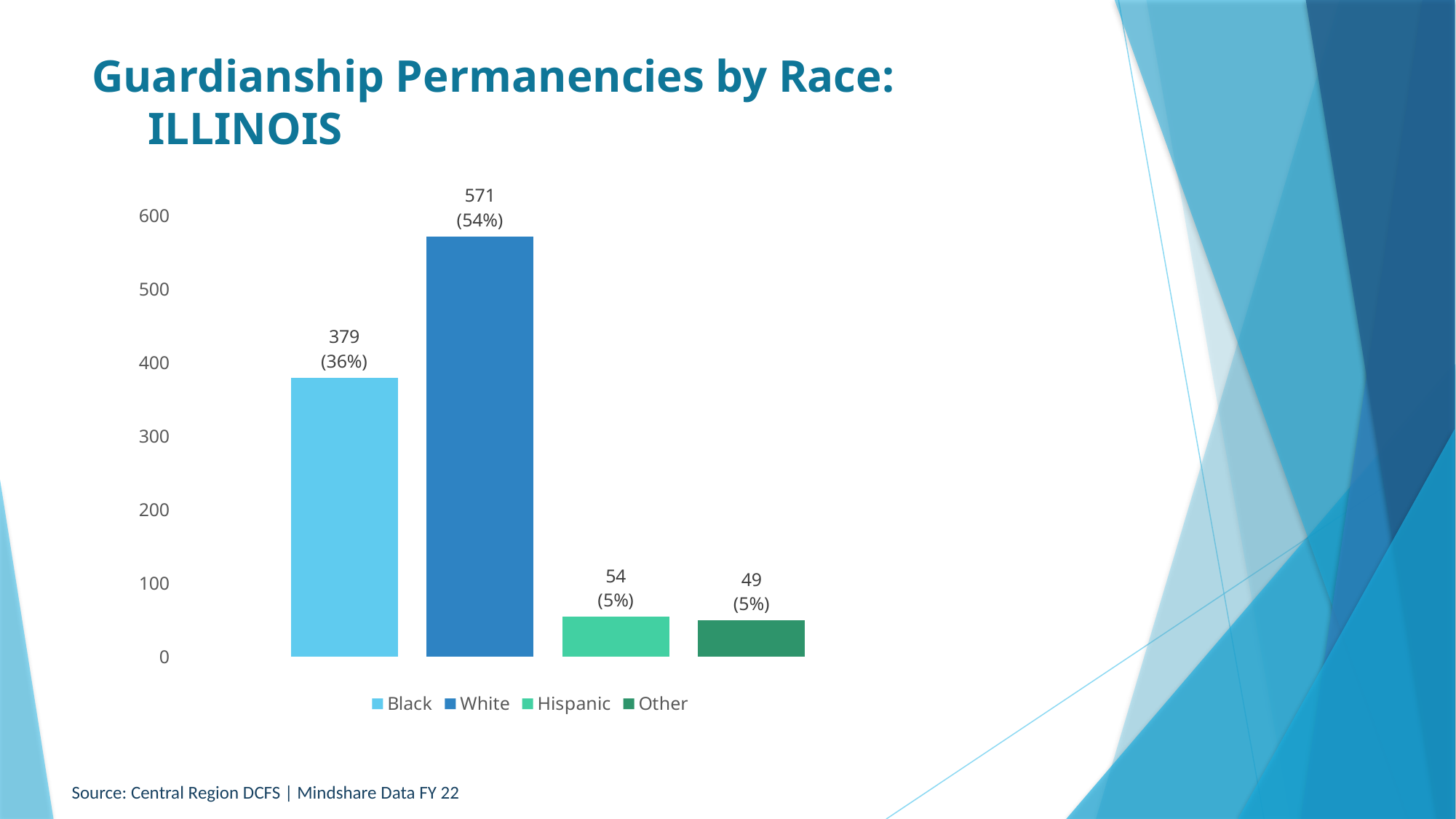
What is the value for Black? 379 What kind of chart is shown on the slide? bar chart Is the value for Black greater or less than 400? less What percentage is shown for Other? 5% What is the value for White? 571 Which is larger, the value for Hispanic or the value for Other? Hispanic How many categories are shown in the chart? 4 Which category has the lowest value? Other What is the difference between the values for White and Black? 192 What is the source cited at the bottom of the slide? Central Region DCFS | Mindshare Data FY 22 What is the value for Hispanic? 54 Which category has the highest value? White